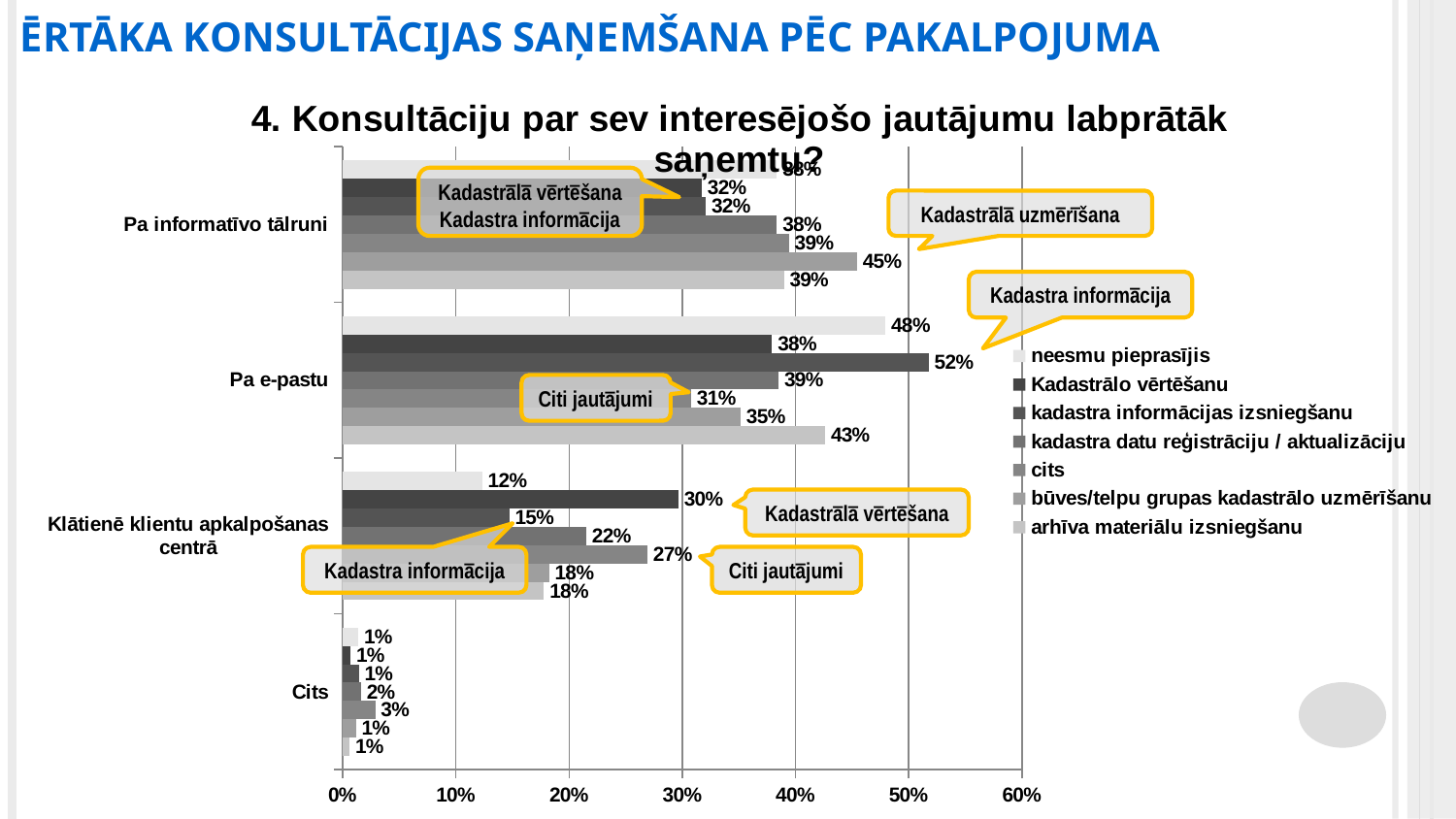
Which is larger: the 'neesmu pieprasījis' value for 'Pa e-pastu' or for 'Klātienē klientu apkalpošanas centrā'? Pa e-pastu What is the difference between the highest value in 'Pa e-pastu' (52%) and the highest value in 'Pa informatīvo tālruni' (45%)? 7 percentage points Which category contains the single largest bar in the chart? Pa e-pastu What is the value for 'neesmu pieprasījis' in the 'Pa e-pastu' category? 48% What is the highest value shown in the 'Pa e-pastu' group? 52% How many series does the legend list? 7 How many categories are shown on the vertical axis of the chart? 4 What kind of chart is shown on the slide? bar chart Which category has the lowest values overall? Cits What is the highest value shown in the 'Cits' category? 3% What is the value for 'neesmu pieprasījis' in the 'Klātienē klientu apkalpošanas centrā' category? 12%